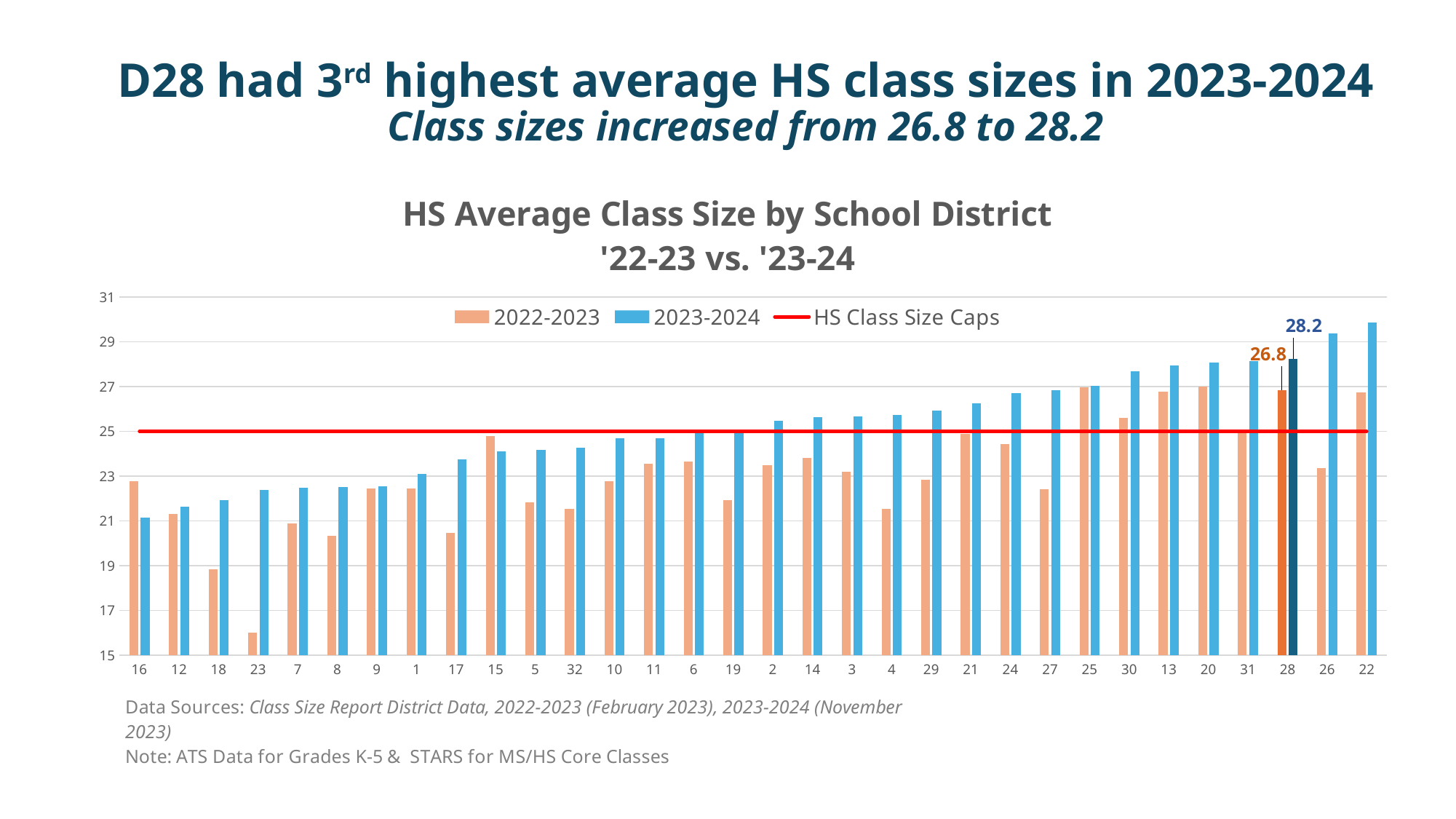
What is the 2022-2023 average HS class size for district 28? 26.8 What is the 2023-2024 average HS class size for district 28? 28.2 How many school districts are shown on the x axis of the chart? 32 Do the 2023-2024 values rise or fall moving from left to right along the x axis? rise What kind of chart is used to show HS average class size by school district? Bar chart Is the 2023-2024 value for district 16 greater or less than 23? less By how much did district 28's average HS class size increase from 2022-2023 to 2023-2024? 1.4 Which district has the lowest 2022-2023 average HS class size? 23 How many entries does the chart's legend list? 3 Is the 2022-2023 value for district 22 greater or less than 25? greater At what value is the HS Class Size Caps line drawn? 25 Which district has the highest 2023-2024 average HS class size? 22